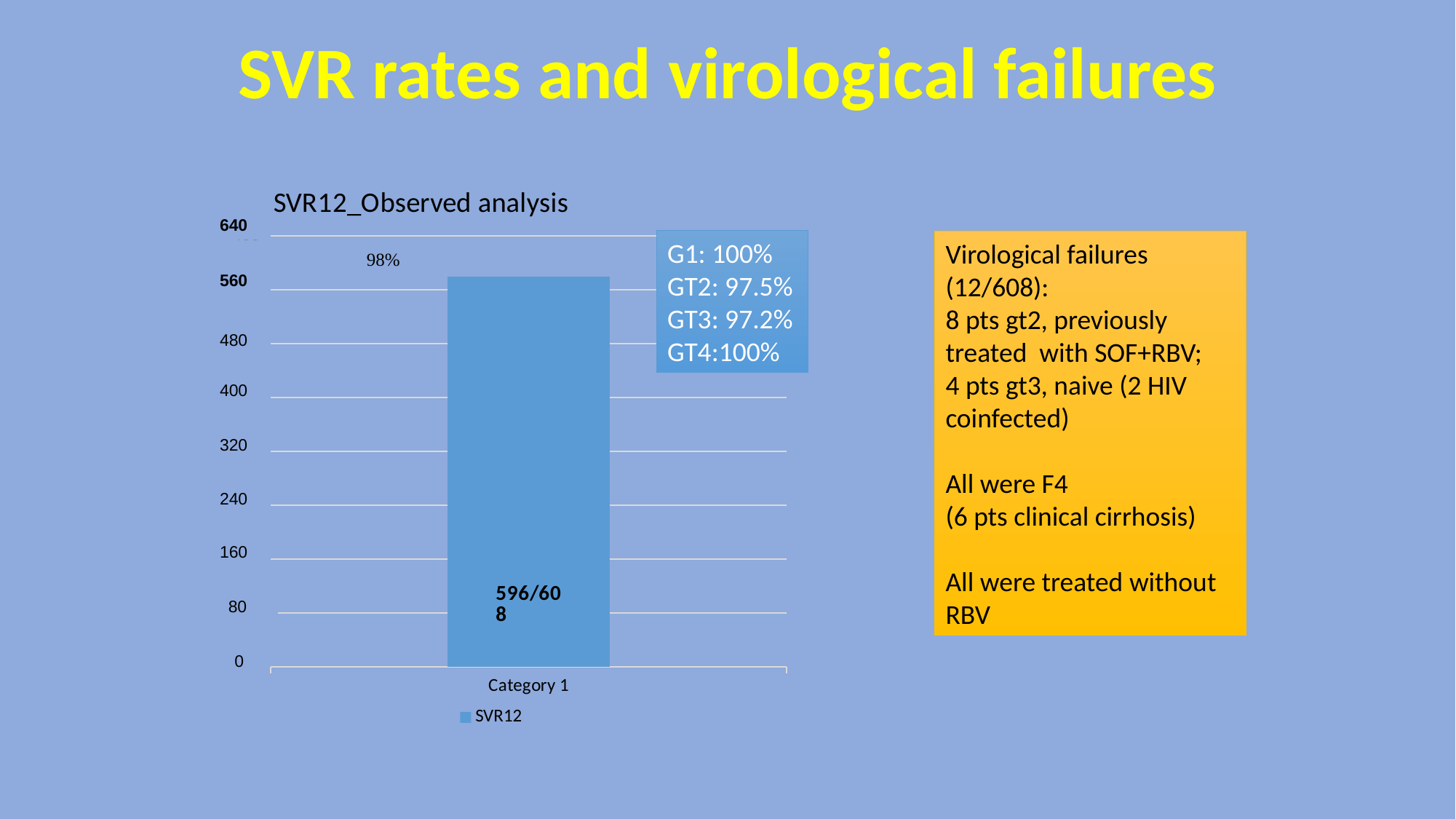
Is the value of the bar for Category 1 greater or less than 640? less How many series does the chart legend list? 1 What is the category label shown on the x axis of the chart? Category 1 Is the value of the bar for Category 1 greater or less than 560? greater What data label is printed on the bar for Category 1? 596/608 What kind of chart is shown on the slide? bar chart What is the highest value shown on the vertical axis of the chart? 640 What is the title of the chart? SVR12_Observed analysis What series name is shown in the chart legend? SVR12 What percentage is printed above the bar for Category 1? 98% How many bars does the chart show? 1